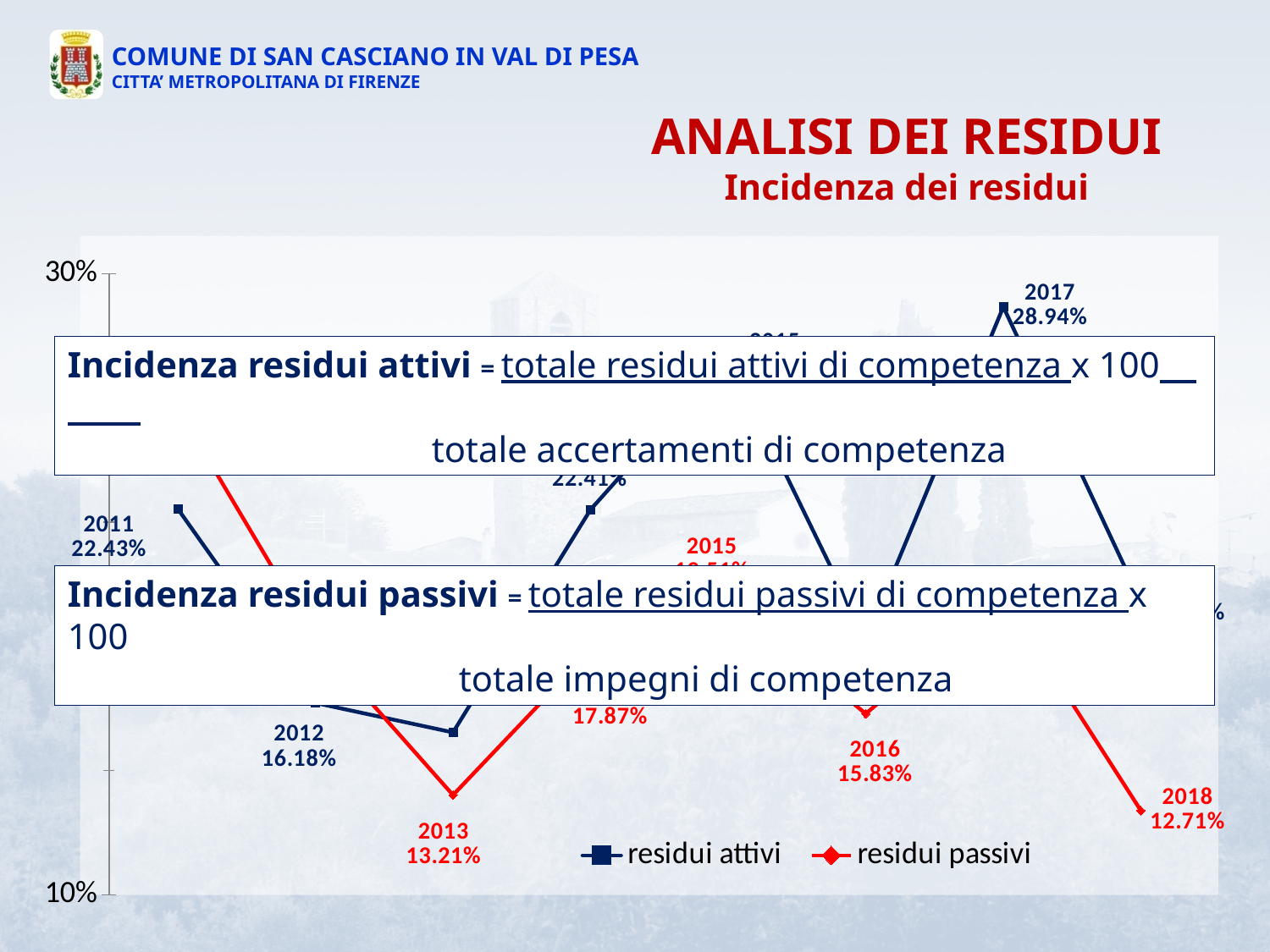
In which year does residui attivi reach its highest value? 2017 What is the value of residui passivi in 2013? 13.21% What is the difference between residui attivi in 2011 and in 2012? 6.25 percentage points What is the value of residui attivi in 2011? 22.43% What is the value of residui attivi in 2012? 16.18% What is the value of residui attivi in 2017? 28.94% Which is larger: residui passivi in 2016 or in 2013? 2016 What is the value of residui passivi in 2016? 15.83% What is the value of residui passivi in 2018? 12.71% What kind of chart is shown on the slide? Line chart How many series does the legend list? 2 What is the difference between residui attivi in 2017 and in 2011? 6.51 percentage points